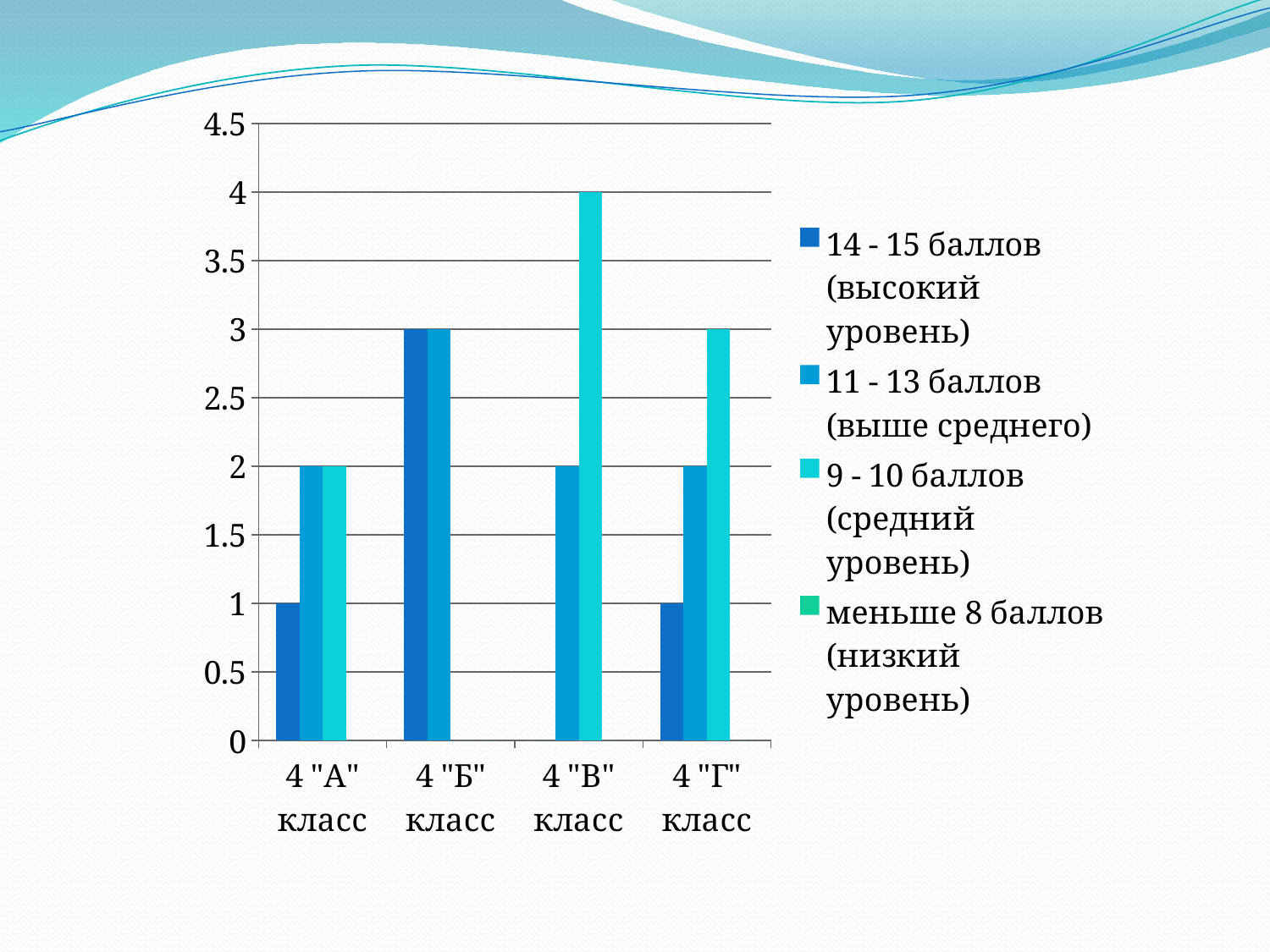
Is the value for 9 - 10 баллов in 4 "В" класс greater or less than 3? greater Which is larger: the 11 - 13 баллов value for 4 "Б" класс or for 4 "А" класс? 4 "Б" класс What is the value for 9 - 10 баллов (средний уровень) in 4 "В" класс? 4 What kind of chart is shown on the slide? bar chart What is the value for 11 - 13 баллов (выше среднего) in 4 "Г" класс? 2 Which class has the highest bar for 9 - 10 баллов (средний уровень)? 4 "В" класс What is the difference between the 9 - 10 баллов value for 4 "В" класс and for 4 "Г" класс? 1 What is the value for 14 - 15 баллов (высокий уровень) in 4 "Б" класс? 3 Which class has the highest value for 14 - 15 баллов (высокий уровень)? 4 "Б" класс How many series does the legend list? 4 What is the value for 14 - 15 баллов (высокий уровень) in 4 "А" класс? 1 How many classes (categories) are shown on the x axis? 4